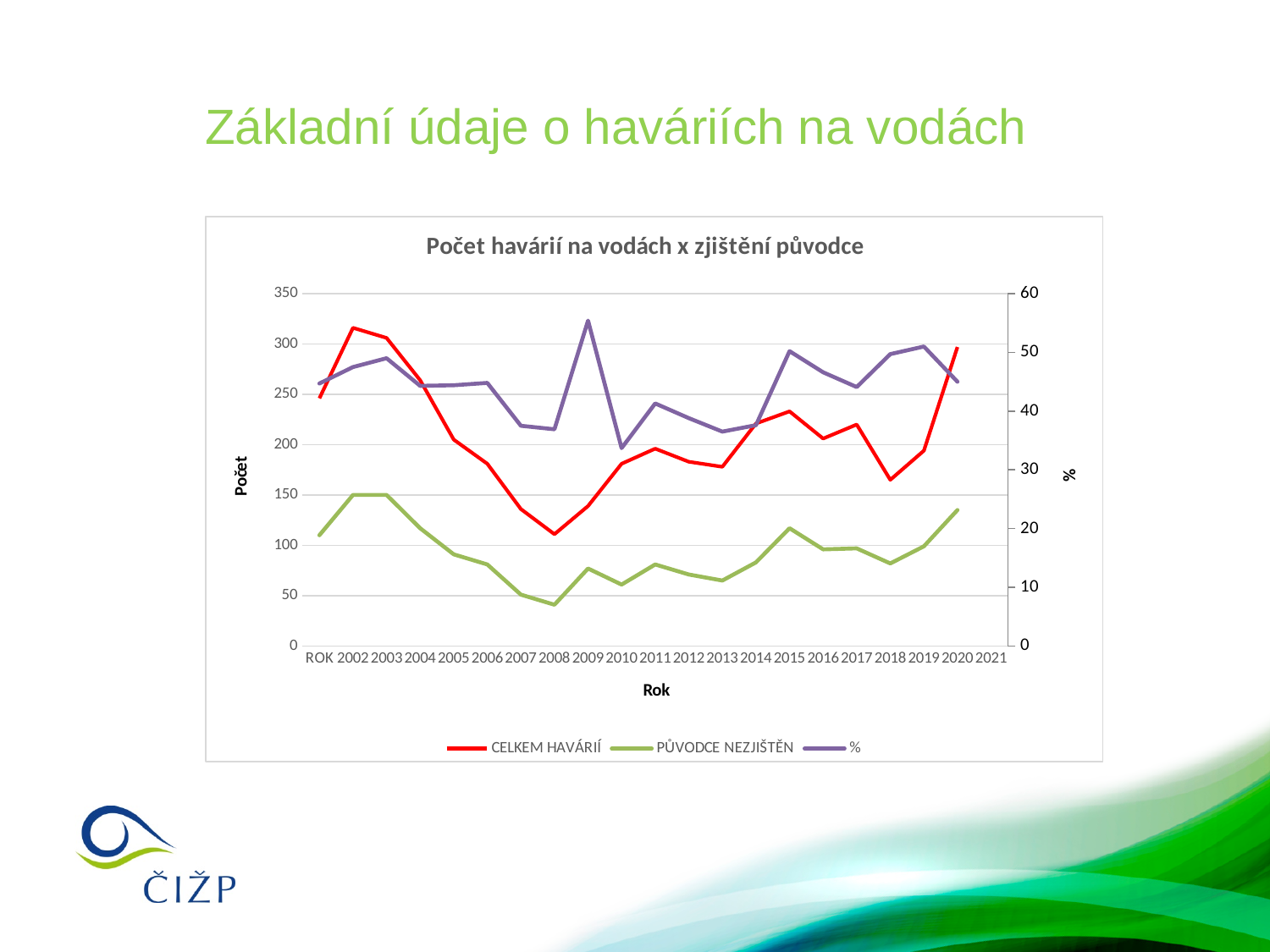
In which year does the % series reach its highest value? 2009 Does the CELKEM HAVÁRIÍ series rise or fall between 2002 and 2008? fall Is the value of PŮVODCE NEZJIŠTĚN in 2008 greater or less than 50? less Is the value of CELKEM HAVÁRIÍ in 2002 greater or less than 300? greater In which year does the CELKEM HAVÁRIÍ series reach its lowest value? 2008 What kind of chart is shown on the slide? line chart Which is larger for CELKEM HAVÁRIÍ: the value in 2015 or the value in 2018? 2015 Is the value of CELKEM HAVÁRIÍ in 2008 greater or less than 150? less What is the label of the left vertical axis? Počet How many series does the chart legend list? 3 What is the title of the chart? Počet havárií na vodách x zjištění původce